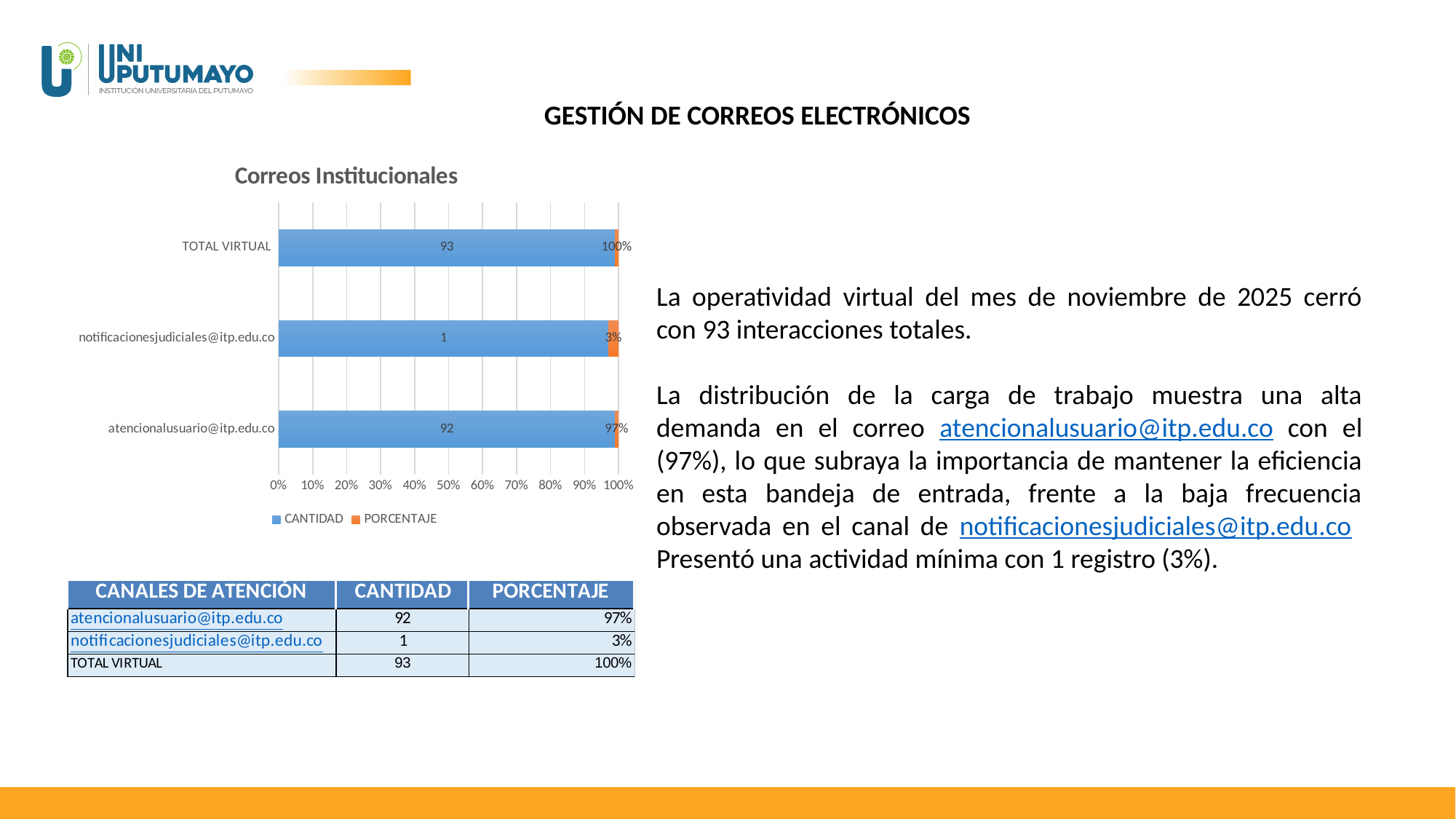
What type of chart is shown on the slide? bar chart How many categories are shown on the chart's vertical axis? 3 What is the PORCENTAJE value for notificacionesjudiciales@itp.edu.co? 3% What is the CANTIDAD value for atencionalusuario@itp.edu.co? 92 What are the names of the series in the chart legend? CANTIDAD and PORCENTAJE What is the CANTIDAD value for TOTAL VIRTUAL? 93 What is the CANTIDAD value for notificacionesjudiciales@itp.edu.co? 1 What is the PORCENTAJE value for atencionalusuario@itp.edu.co? 97% What is the title of the chart? Correos Institucionales How many series does the chart legend list? 2 What is the difference in CANTIDAD between atencionalusuario@itp.edu.co and notificacionesjudiciales@itp.edu.co? 91 Which category has the lowest CANTIDAD value? notificacionesjudiciales@itp.edu.co